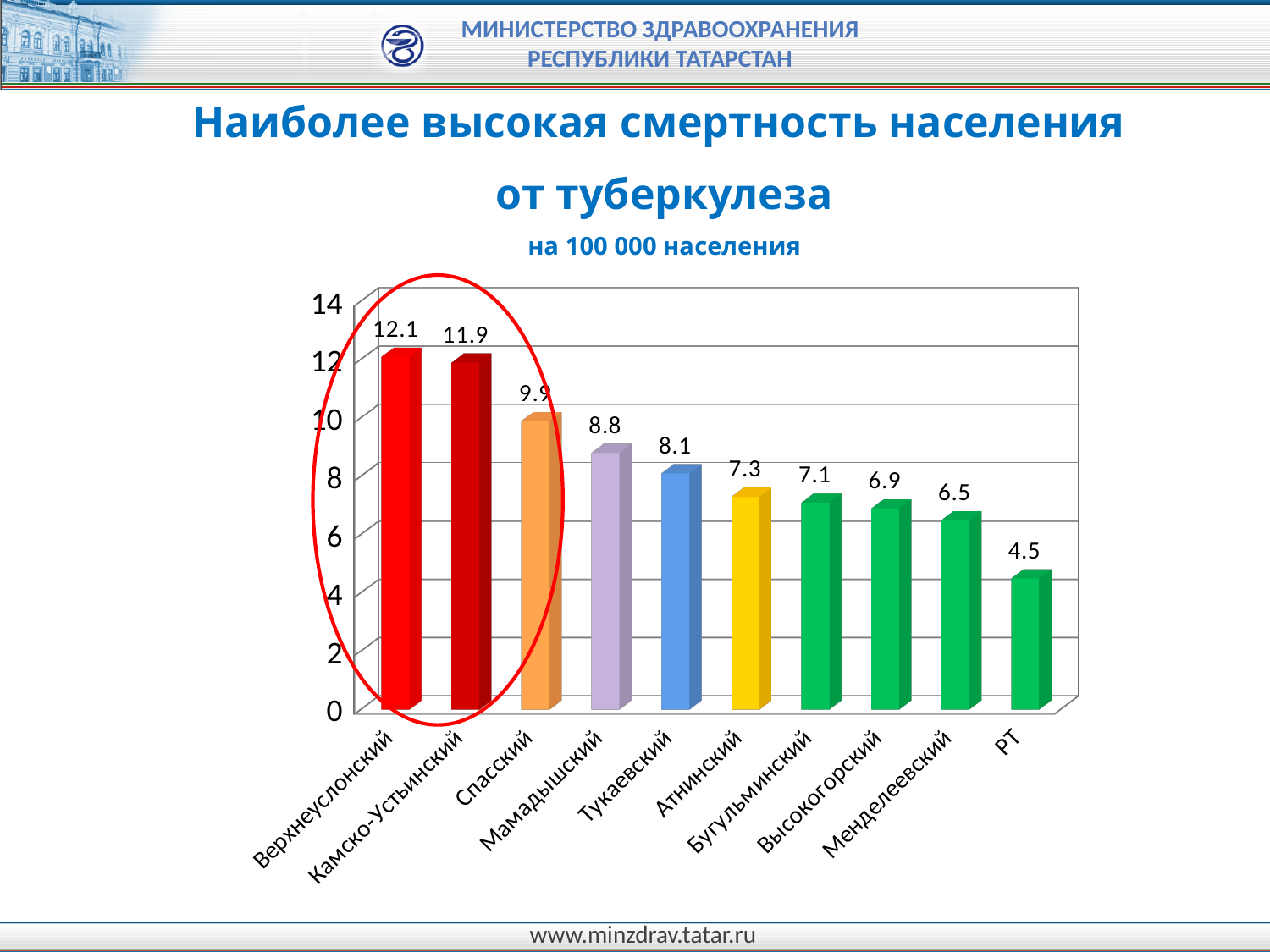
Do the values rise or fall from left to right along the x axis? fall What is the difference between the values for Мамадышский and Менделеевский? 2.3 What is the value shown for РТ? 4.5 What is the value shown for Тукаевский? 8.1 What is the difference between the values for Верхнеуслонский and РТ? 7.6 Which is larger, the value for Атнинский or the value for Высокогорский? Атнинский Which category has the lowest value on the chart? РТ Which district has the highest tuberculosis mortality on the chart? Верхнеуслонский How many categories are shown on the x axis? 10 What is the tuberculosis mortality value for Спасский? 9.9 What kind of chart is shown on the slide? bar chart Is the value for Камско-Устьинский greater or less than 10? greater